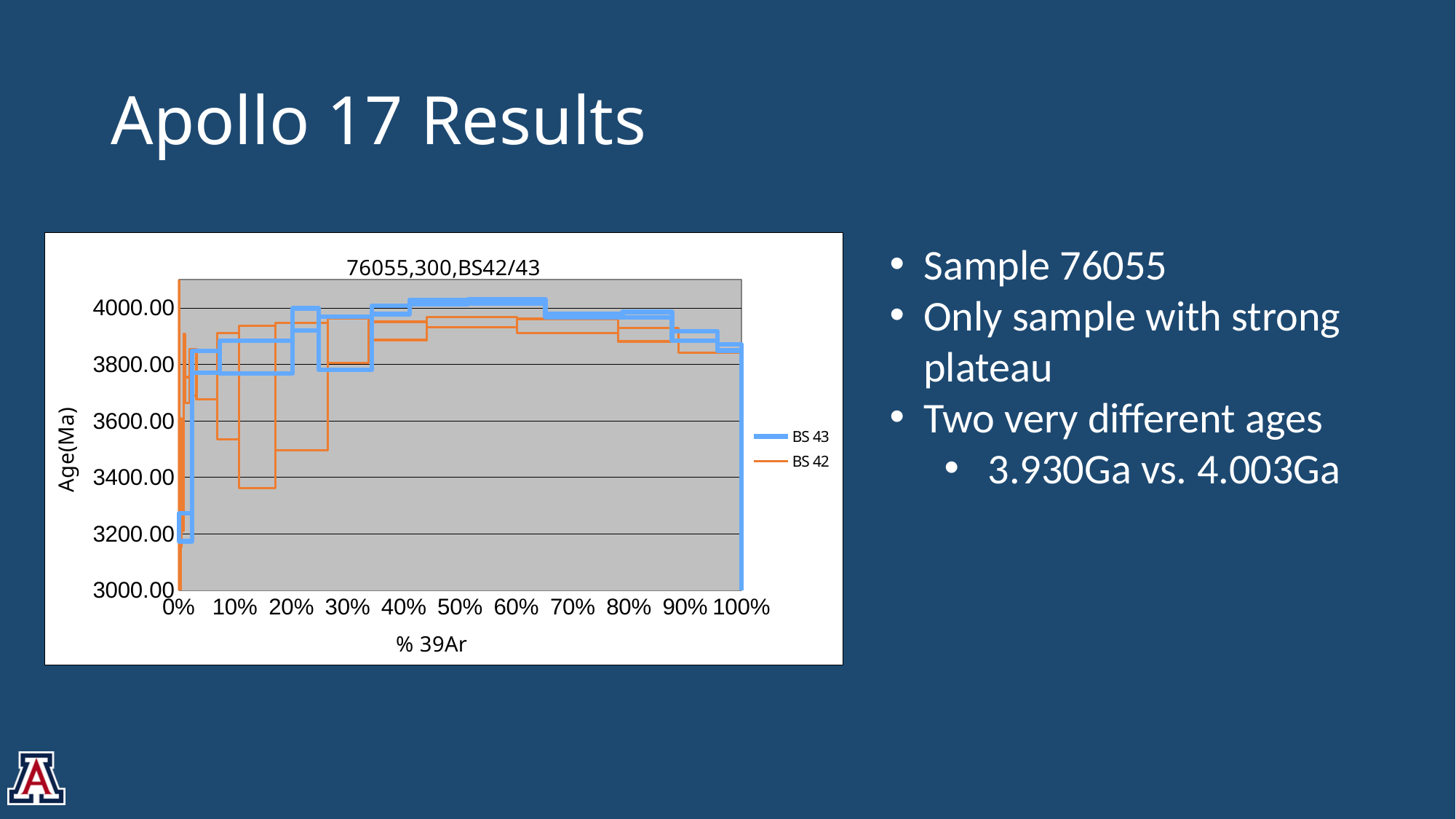
Is the BS 43 value at 0% 39Ar greater or less than 3400? less What is the highest value labelled on the y axis of the chart? 4000.00 What kind of chart is shown on the slide? line chart What is the title of the chart? 76055,300,BS42/43 Do the BS 43 ages generally rise or fall between 0% and 50% 39Ar? rise Is the BS 43 value at 50% 39Ar greater or less than 3800? greater What is the label of the chart's y axis? Age(Ma) What are the names of the two series in the chart legend? BS 43 and BS 42 How many tick labels are shown on the x axis of the chart? 11 What is the lowest value labelled on the y axis of the chart? 3000.00 How many series does the chart legend list? 2 What is the label of the chart's x axis? % 39Ar